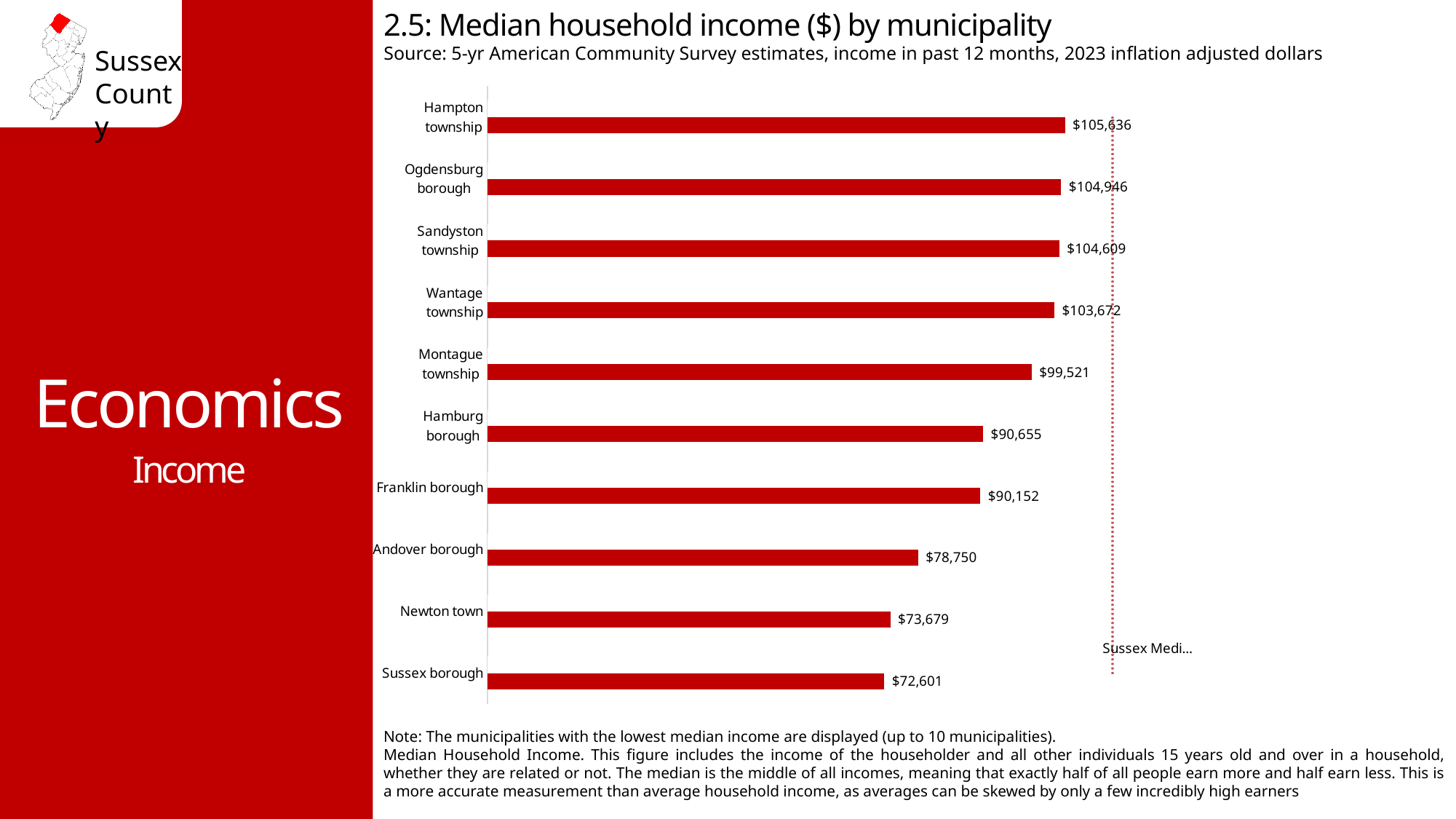
What is the median household income for Hamburg borough? $90,655 What is the median household income for Newton town? $73,679 What is the median household income for Andover borough? $78,750 Which has a higher median household income, Newton town or Sussex borough? Newton town Which municipality has the highest median household income in the chart? Hampton township What is the difference in median household income between Hampton township and Sussex borough? $33,035 What is the title of the chart? 2.5: Median household income ($) by municipality How many municipalities are shown in the chart? 10 What is the median household income for Montague township? $99,521 What type of chart is shown on the slide? bar chart Which municipality has the lowest median household income in the chart? Sussex borough What is the difference in median household income between Hamburg borough and Franklin borough? $503